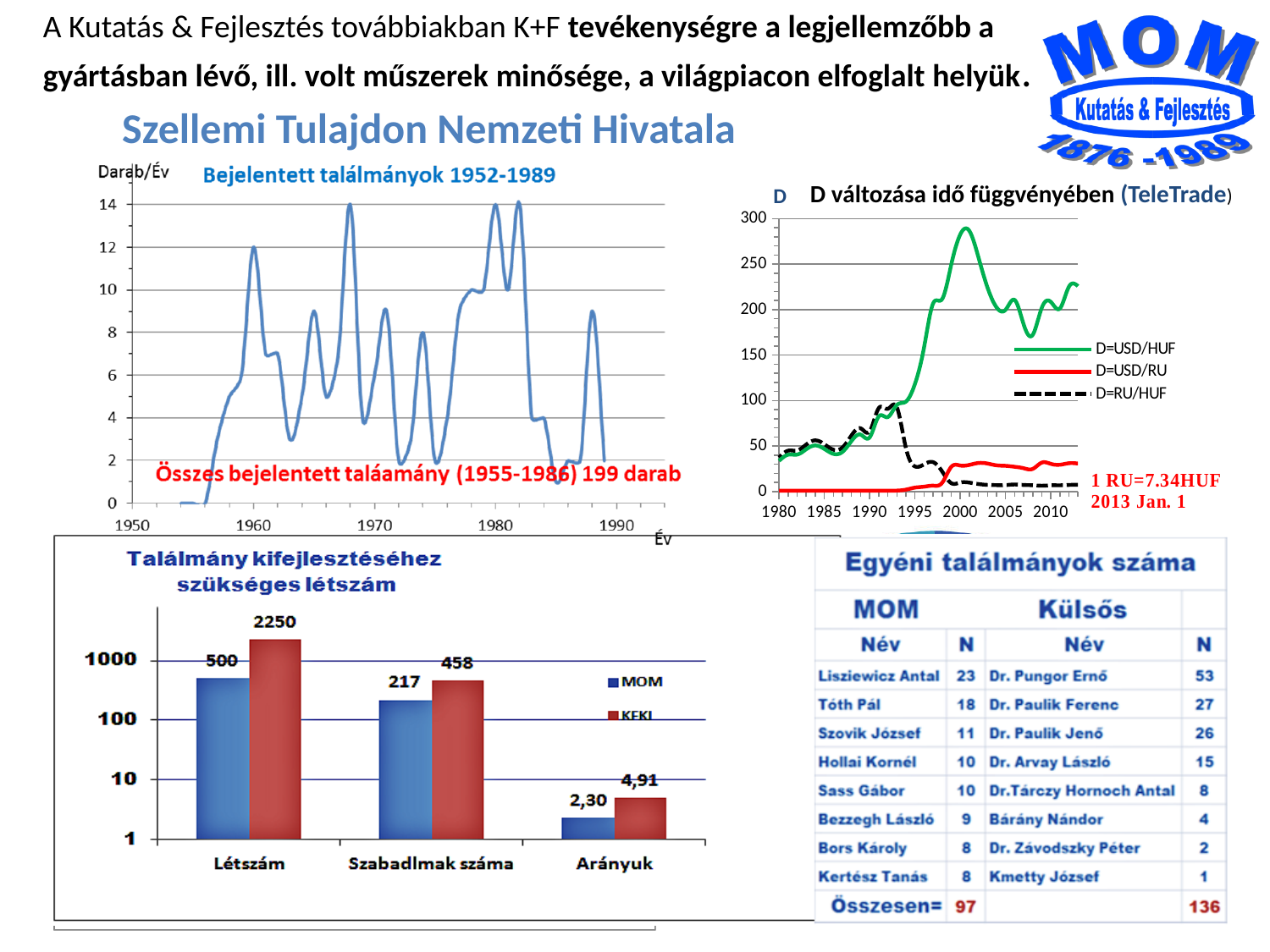
In the 'Találmány kifejlesztéséhez szükséges létszám' chart, which category has the highest MOM value? Létszám In the 'D változása idő függvényében' chart, is the D=USD/HUF value in 2010 greater or less than 150? greater How many series does the legend of the 'D változása idő függvényében' chart list? 3 In the 'Találmány kifejlesztéséhez szükséges létszám' chart, how many categories are shown on the x axis? 3 In the 'Találmány kifejlesztéséhez szükséges létszám' chart, what is the MOM value for Szabadalmak száma? 217 In the 'Találmány kifejlesztéséhez szükséges létszám' chart, what is the KFKI value for Létszám? 2250 What kind of chart is 'Bejelentett találmányok 1952-1989'? line chart In the 'Találmány kifejlesztéséhez szükséges létszám' chart, what is the difference between the KFKI and MOM values for Létszám? 1750 In the 'Találmány kifejlesztéséhez szükséges létszám' chart, which is larger for Szabadalmak száma, MOM or KFKI? KFKI What kind of chart is 'Találmány kifejlesztéséhez szükséges létszám'? bar chart In the 'Találmány kifejlesztéséhez szükséges létszám' chart, what is the KFKI value for Arányuk? 4,91 In the 'D változása idő függvényében' chart, is the D=USD/RU value in 2010 greater or less than 50? less